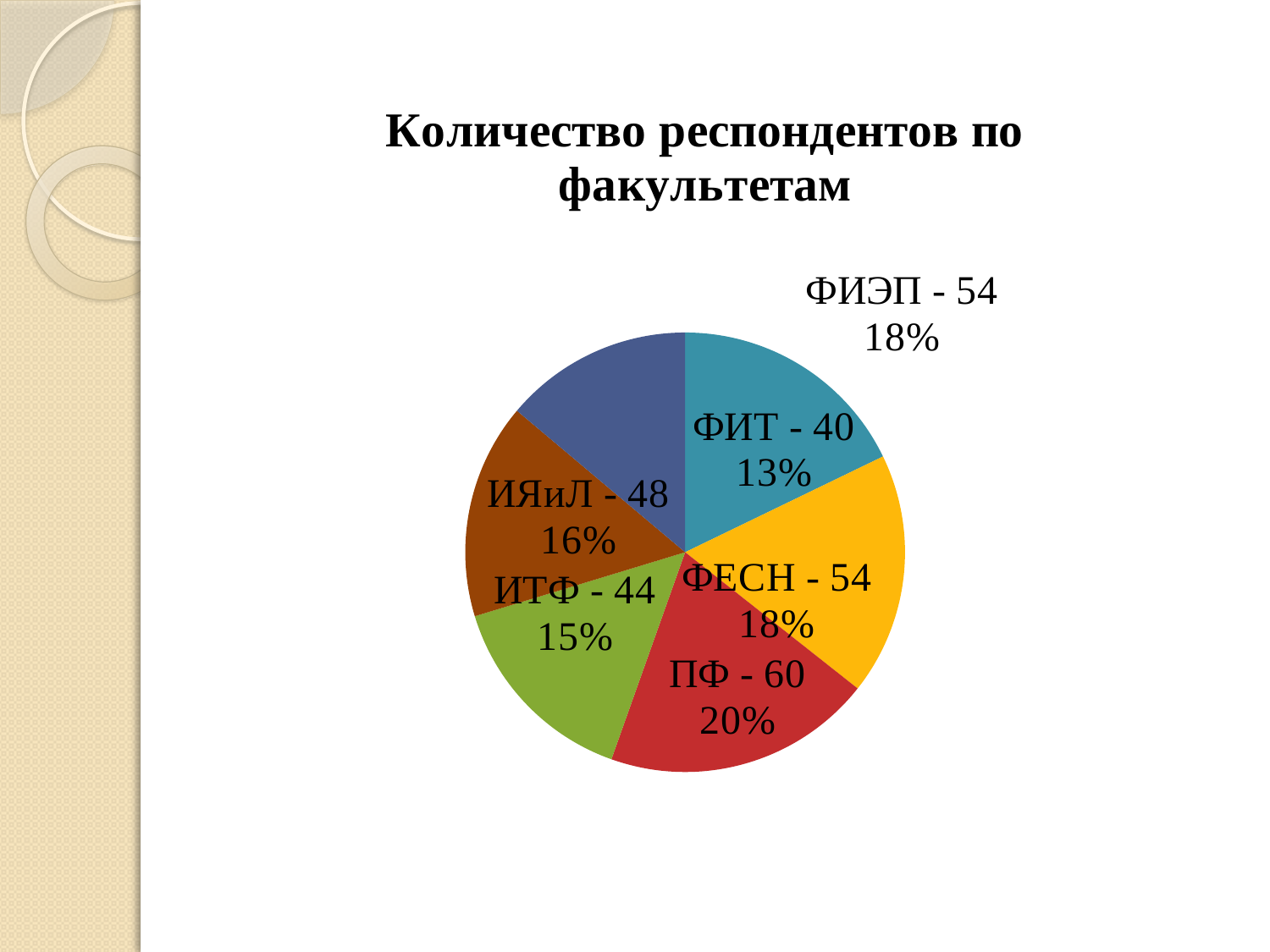
Which has more respondents, ИЯиЛ or ИТФ? ИЯиЛ How many slices does the pie chart have? 6 What share of the pie does ФИЭП represent? 18% Which faculty has the smallest number of respondents? ФИТ How many respondents are from ПФ? 60 How many respondents are from ИЯиЛ? 48 What is the title of the chart? Количество респондентов по факультетам Which faculty has the largest number of respondents? ПФ What share of the pie does ИТФ represent? 15% What kind of chart is shown on the slide? pie chart What is the difference between the number of respondents from ПФ and from ФИТ? 20 How many respondents are from ФИТ? 40